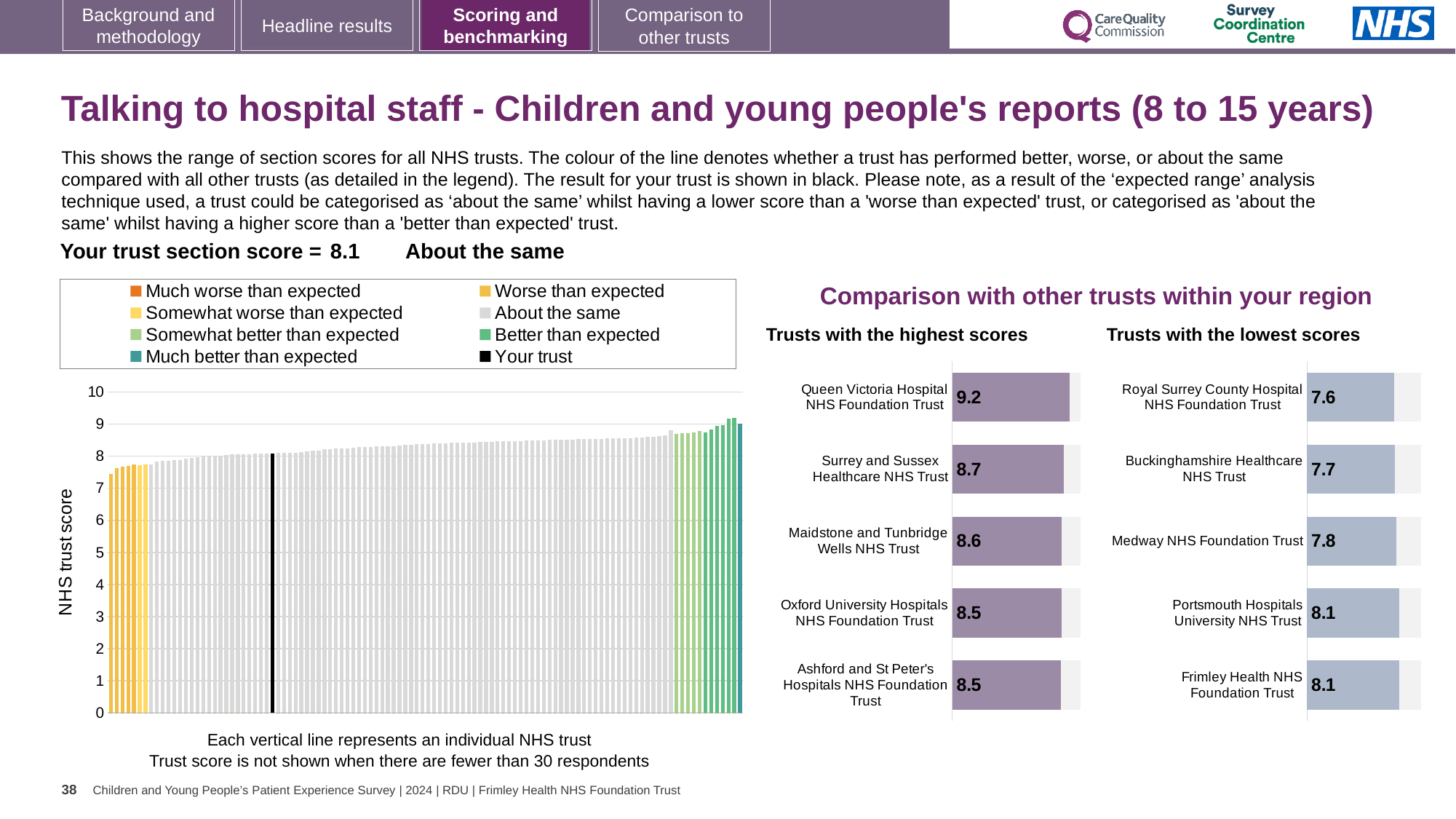
In the 'Trusts with the highest scores' chart, what is the difference between the scores of Queen Victoria Hospital NHS Foundation Trust and Surrey and Sussex Healthcare NHS Trust? 0.5 In the 'Trusts with the lowest scores' chart, what is the score for Frimley Health NHS Foundation Trust? 8.1 In the 'Trusts with the lowest scores' chart, which trust has the lowest score? Royal Surrey County Hospital NHS Foundation Trust What kind of chart is the 'NHS trust score' chart on the left of the slide? Bar chart How many entries does the legend of the 'NHS trust score' chart on the left list? 8 In the 'Trusts with the highest scores' chart, which trust has the highest score? Queen Victoria Hospital NHS Foundation Trust In the 'Trusts with the highest scores' chart, what is the score for Queen Victoria Hospital NHS Foundation Trust? 9.2 In the 'NHS trust score' chart on the left, what colour is the bar for 'Your trust'? Black In the 'Trusts with the lowest scores' chart, which has the larger score: Buckinghamshire Healthcare NHS Trust or Portsmouth Hospitals University NHS Trust? Portsmouth Hospitals University NHS Trust How many trusts are shown in the 'Trusts with the lowest scores' chart? 5 In the 'NHS trust score' chart on the left, do the bar heights rise or fall from left to right? Rise In the 'Trusts with the lowest scores' chart, what is the score for Medway NHS Foundation Trust? 7.8